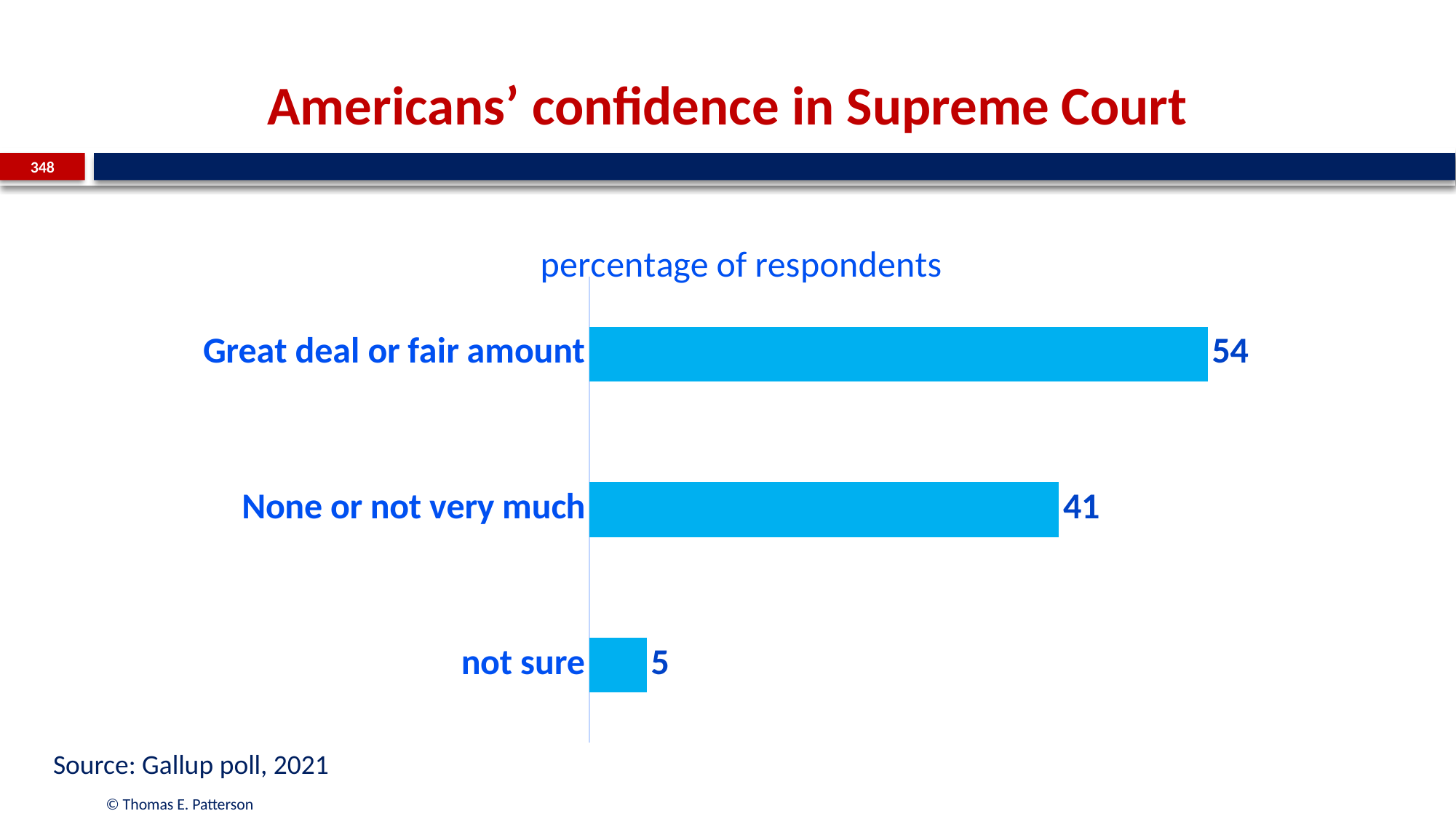
What is the difference between the percentage for 'None or not very much' and 'not sure'? 36 What is the title of the chart? percentage of respondents Which category has the lowest percentage of respondents? not sure What percentage of respondents have none or not very much confidence in the Supreme Court? 41 Which category has the highest percentage of respondents? Great deal or fair amount What is the difference between the percentage for 'Great deal or fair amount' and 'None or not very much'? 13 What percentage of respondents are not sure? 5 What kind of chart is shown on the slide? bar chart Which is larger: the percentage for 'Great deal or fair amount' or for 'None or not very much'? Great deal or fair amount How many categories are shown in the chart? 3 What percentage of respondents have a great deal or fair amount of confidence in the Supreme Court? 54 What is the source of the data shown in the chart? Gallup poll, 2021